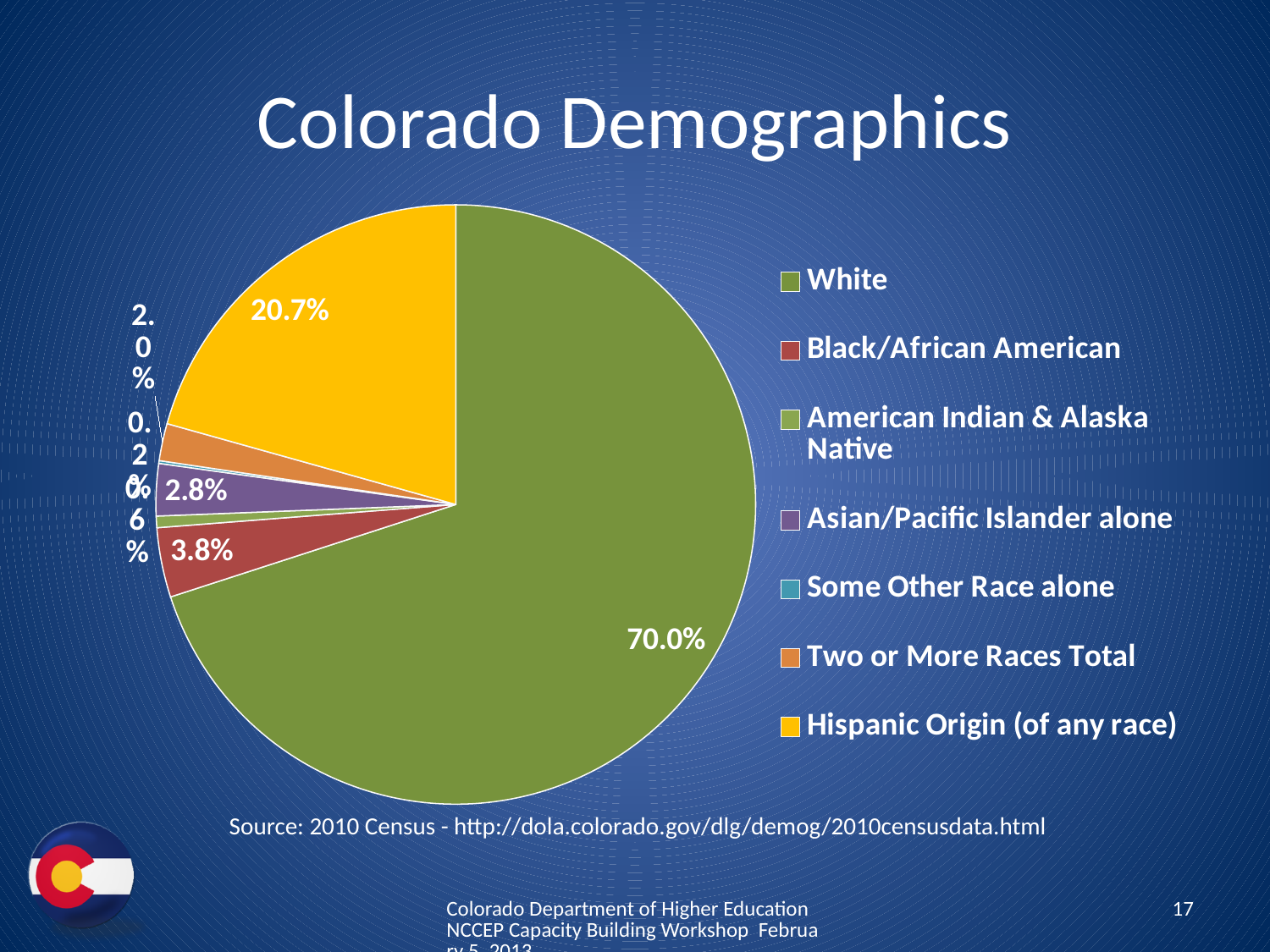
What is the difference in percentage points between the White slice and the Hispanic Origin (of any race) slice? 49.3% What percentage is shown for Black/African American? 3.8% What is the title of the chart on the slide? Colorado Demographics Which is larger, the slice for Black/African American or the slice for Asian/Pacific Islander alone? Black/African American What is the difference in percentage points between the Black/African American slice and the Asian/Pacific Islander alone slice? 1.0% Which category has the largest slice of the pie? White Which is larger, the slice for Hispanic Origin (of any race) or the slice for Black/African American? Hispanic Origin (of any race) What percentage is shown for Asian/Pacific Islander alone? 2.8% What share of the pie is labelled for White? 70.0% What percentage is shown for Hispanic Origin (of any race)? 20.7% What kind of chart is shown on the slide? pie chart How many categories does the legend list? 7